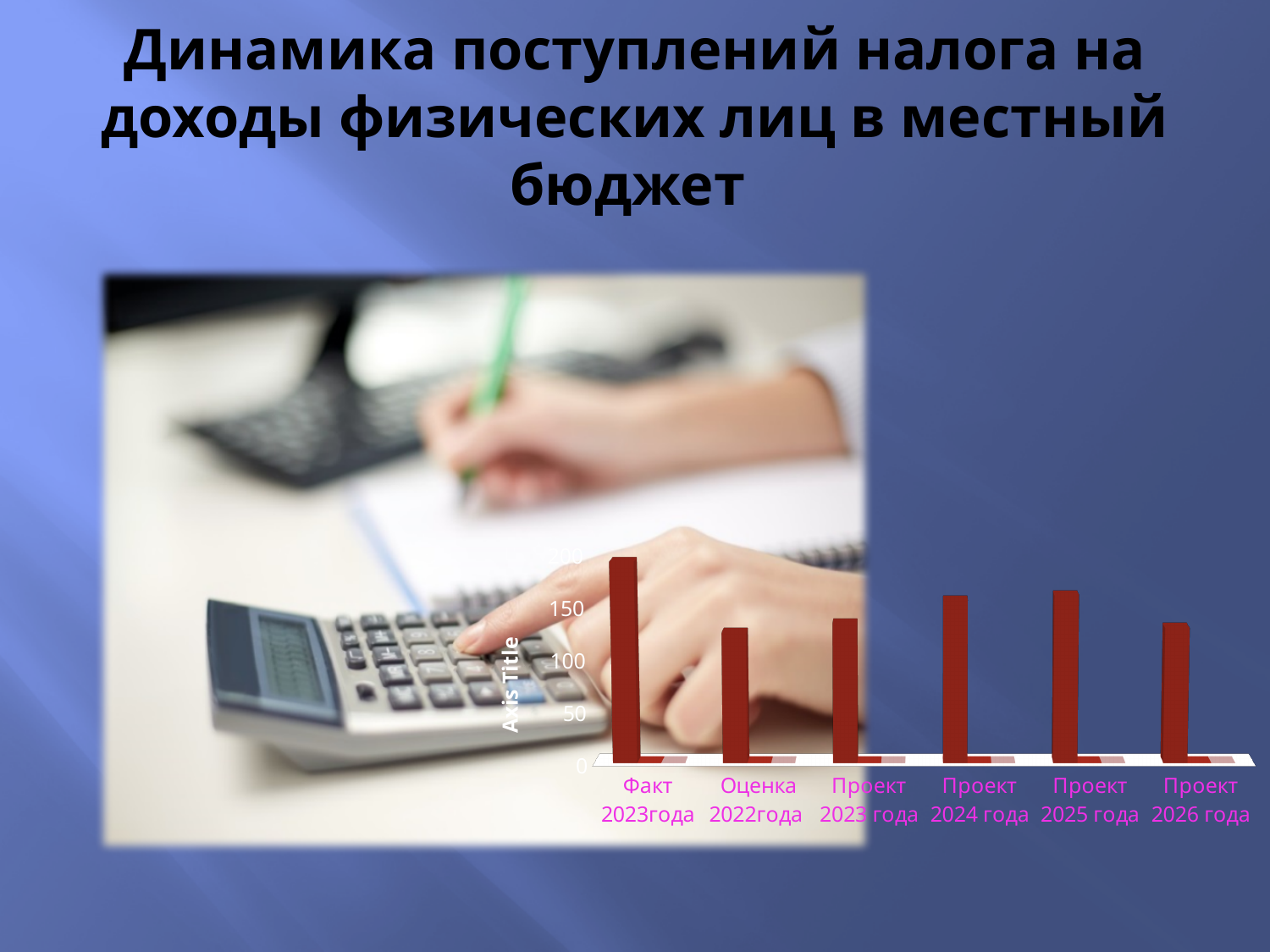
Is the value for Проект 2026 года greater or less than 150? less What is the highest tick value shown on the vertical axis of the chart? 200 Which category has the highest bar in the chart? Факт 2023года Which is larger, the value for Факт 2023года or the value for Оценка 2022года? Факт 2023года Is the value for Факт 2023года greater or less than 150? greater How many categories are shown on the x axis of the chart? 6 Is the value for Проект 2023 года greater or less than 100? greater What kind of chart is shown on the slide? bar chart What is the label shown on the vertical axis of the chart? Axis Title Which is larger, the value for Проект 2025 года or the value for Проект 2026 года? Проект 2025 года